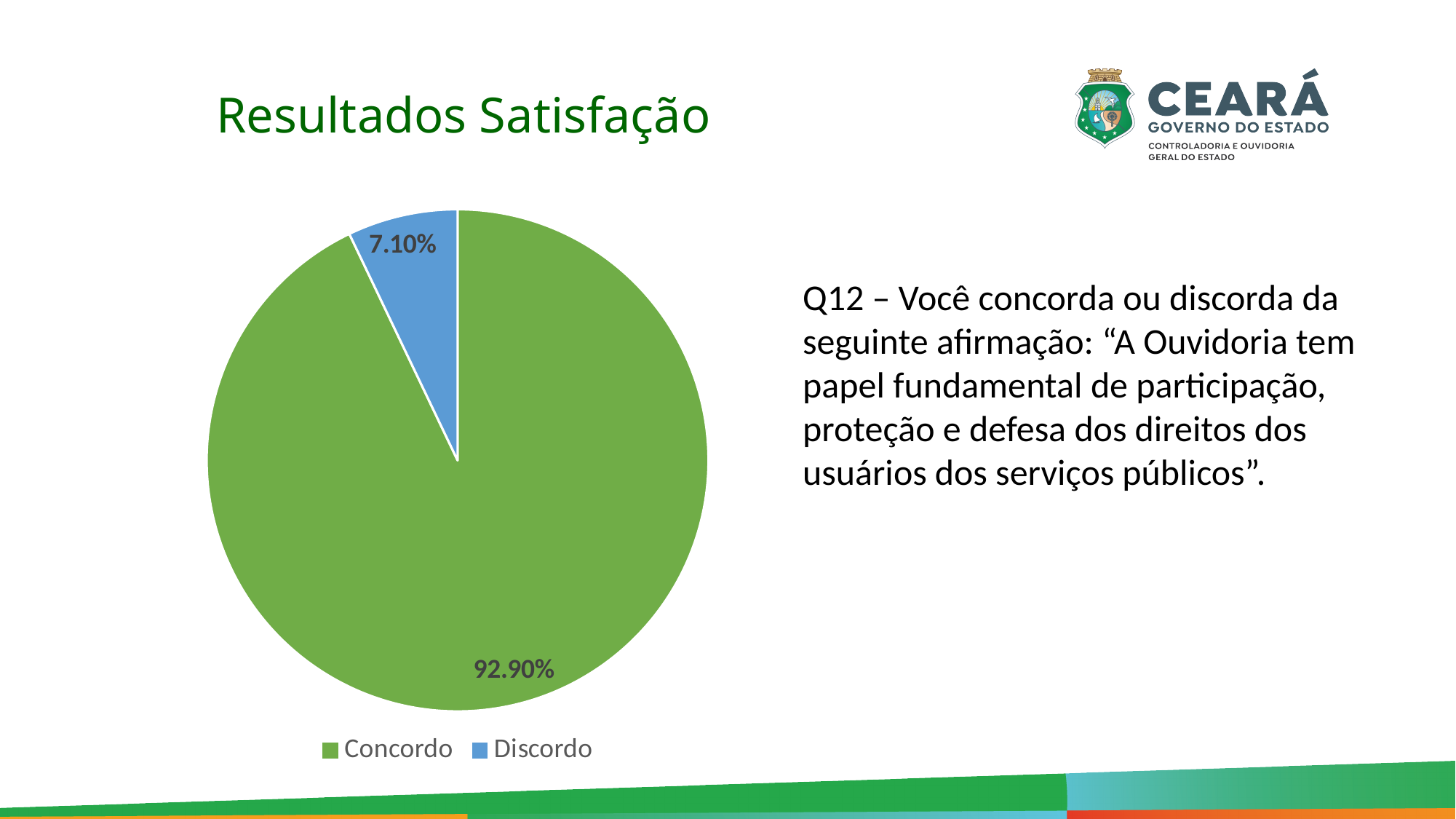
Which category has the smallest share of the pie? Discordo What is the difference in percentage points between "Concordo" and "Discordo"? 85.80 What percentage of respondents answered "Discordo"? 7.10% What colour is the "Concordo" slice? Green What colour is the "Discordo" slice? Blue What percentage of respondents answered "Concordo"? 92.90% Which is larger, the share for "Concordo" or the share for "Discordo"? Concordo What kind of chart is shown on the slide? Pie chart How many entries does the legend list? 2 Which category has the largest share of the pie? Concordo What share of the pie does the "Discordo" slice represent? 7.10% How many categories does the pie chart show? 2